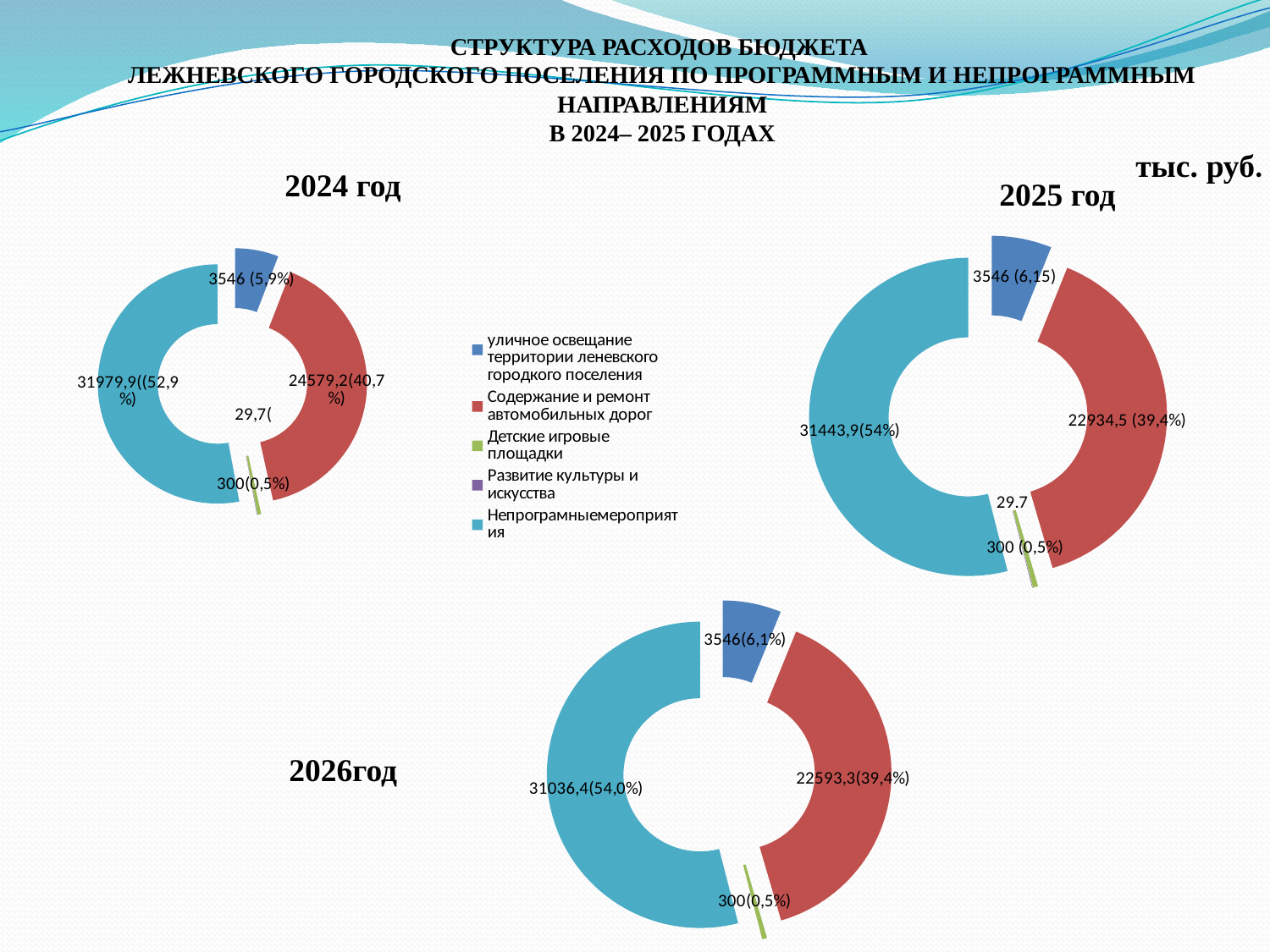
In the 2024 год chart, which is larger: the slice for Содержание и ремонт автомобильных дорог or the slice for уличное освещение? Содержание и ремонт автомобильных дорог In the 2025 год chart, which category has the largest slice? Непрограмные мероприятия In the 2024 год chart, what is the value labelled for Содержание и ремонт автомобильных дорог (the red slice)? 24579,2(40,7%) How many doughnut charts are shown on the slide? 3 In the 2024 год chart, what is the value labelled for Непрограмные мероприятия (the teal slice)? 31979,9((52,9%) How many series does the legend list? 5 In the 2025 год chart, what is the value labelled for Содержание и ремонт автомобильных дорог (the red slice)? 22934,5 (39,4%) In the 2026год chart, what is the value labelled for Содержание и ремонт автомобильных дорог (the red slice)? 22593,3(39,4%) In the 2026год chart, what share of the total does Непрограмные мероприятия (the teal slice) represent? 54,0% In the 2025 год chart, what is the value labelled for Непрограмные мероприятия (the teal slice)? 31443,9(54%) What type of chart is used for the 2024 год chart? doughnut chart In the 2026год chart, what is the value labelled for Непрограмные мероприятия (the teal slice)? 31036,4(54,0%)